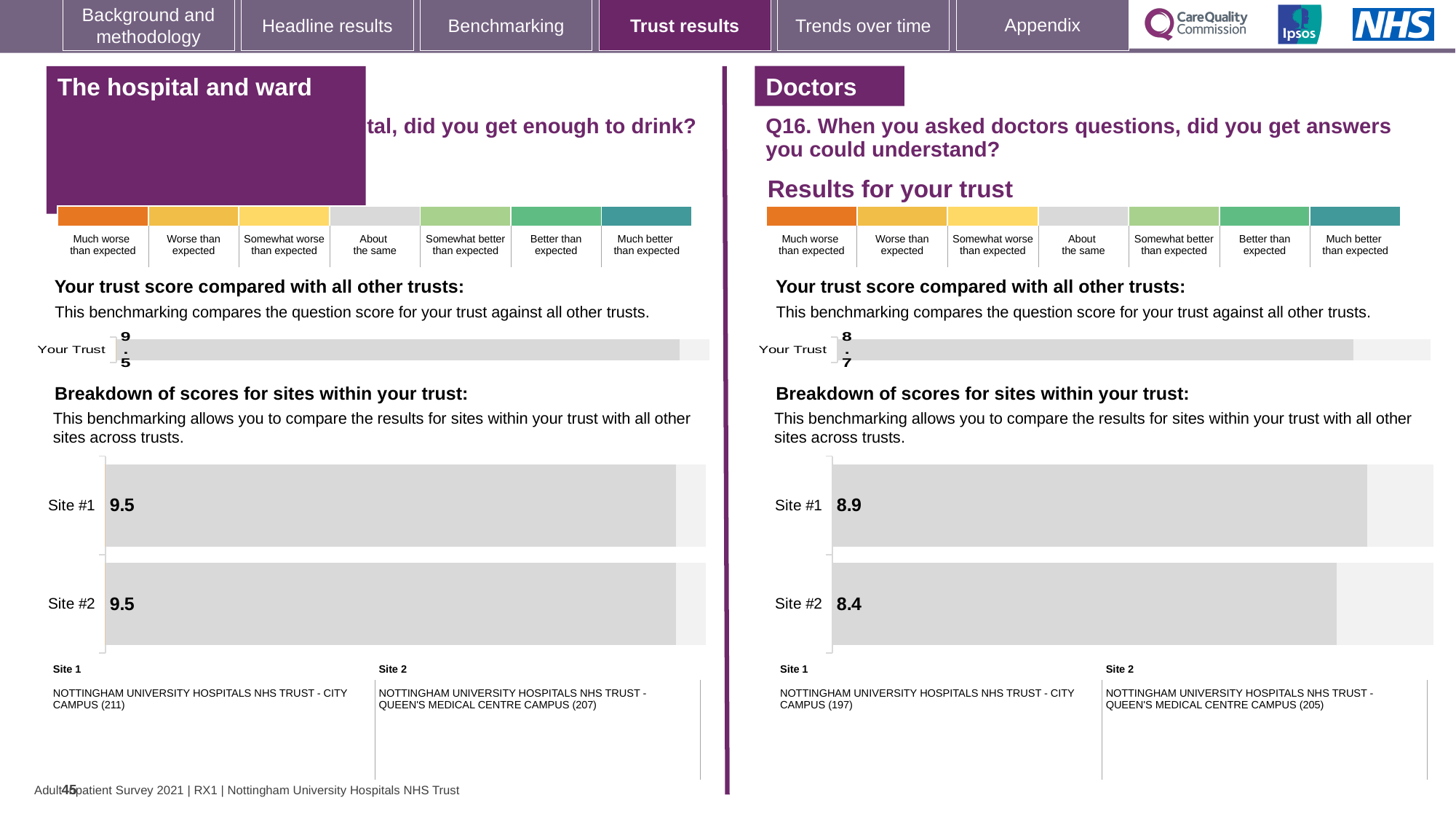
In the right-hand (Doctors, Q16) site breakdown chart, what is the score for Site #2? 8.4 In the right-hand (Doctors, Q16) site breakdown chart, which site has the higher score? Site #1 In the right-hand (Doctors, Q16) site breakdown chart, what is the difference between the scores for Site #1 and Site #2? 0.5 In the left-hand (hospital and ward) 'Your trust score compared with all other trusts' chart, what is the score for Your Trust? 9.5 In the left-hand (hospital and ward) site breakdown chart, what is the score for Site #2? 9.5 What type of chart is the right-hand (Doctors, Q16) site breakdown chart? bar chart How many sites are shown in the left-hand (hospital and ward) site breakdown chart? 2 In the right-hand (Doctors, Q16) site breakdown chart, what is the score for Site #1? 8.9 In the left-hand (hospital and ward) site breakdown chart, what is the score for Site #1? 9.5 In the right-hand (Doctors, Q16) site breakdown chart, which site has the lower score? Site #2 In the right-hand (Doctors, Q16) site breakdown chart, is the score for Site #1 larger or smaller than the score for Site #2? larger In the right-hand (Doctors, Q16) 'Your trust score compared with all other trusts' chart, what is the score for Your Trust? 8.7